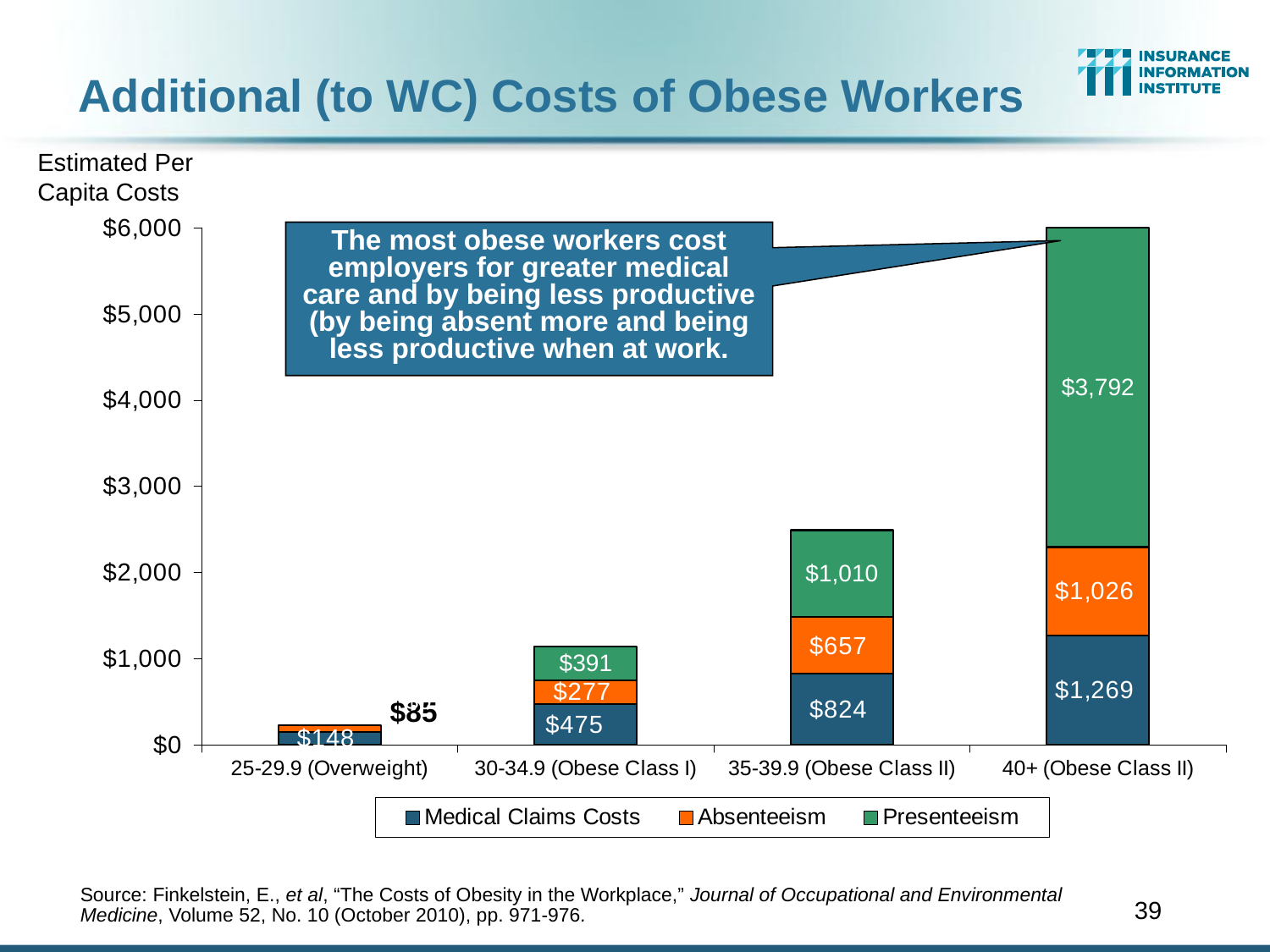
Which category has the highest total estimated per capita cost? 40+ (Obese Class II) What kind of chart is shown on the slide? bar chart What is the Medical Claims Costs value for the 35-39.9 (Obese Class II) category? $824 What is the Presenteeism cost for the 40+ (Obese Class II) category? $3,792 Which category has the lowest total estimated per capita cost? 25-29.9 (Overweight) Do the total per capita costs rise or fall as BMI category increases along the x axis? rise How many series does the chart's legend list? 3 What is the total stacked cost for the 35-39.9 (Obese Class II) category? $2,491 Which is larger: Absenteeism for 35-39.9 (Obese Class II) or Presenteeism for 30-34.9 (Obese Class I)? Absenteeism for 35-39.9 (Obese Class II) What is the Absenteeism cost for the 30-34.9 (Obese Class I) category? $277 How much higher are Medical Claims Costs for 40+ (Obese Class II) than for 35-39.9 (Obese Class II)? $445 How many BMI categories are shown on the x axis of the chart? 4